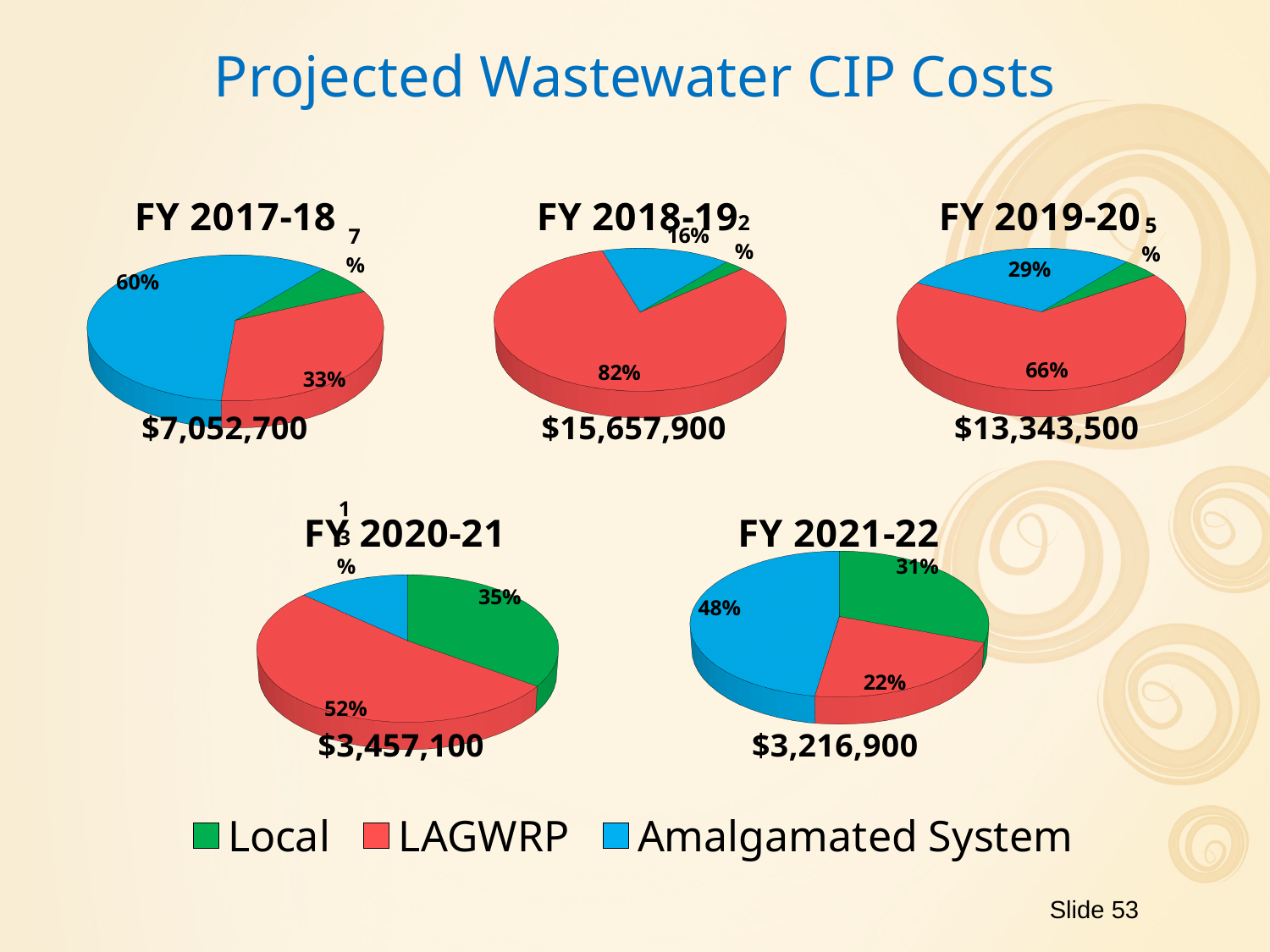
In the FY 2017-18 pie chart, what is the difference between the Amalgamated System share and the LAGWRP share? 27% In the FY 2019-20 pie chart, what share is Amalgamated System? 29% In the FY 2021-22 pie chart, which category has the largest slice? Amalgamated System In the FY 2020-21 pie chart, which is larger, LAGWRP or Local? LAGWRP What kind of chart is used for FY 2019-20? Pie chart In the FY 2021-22 pie chart, what share is LAGWRP? 22% In the FY 2017-18 pie chart, what share is Amalgamated System? 60% How many series does the legend list? 3 In the FY 2018-19 pie chart, which category has the smallest slice? Local What total cost is shown below the FY 2018-19 pie chart? $15,657,900